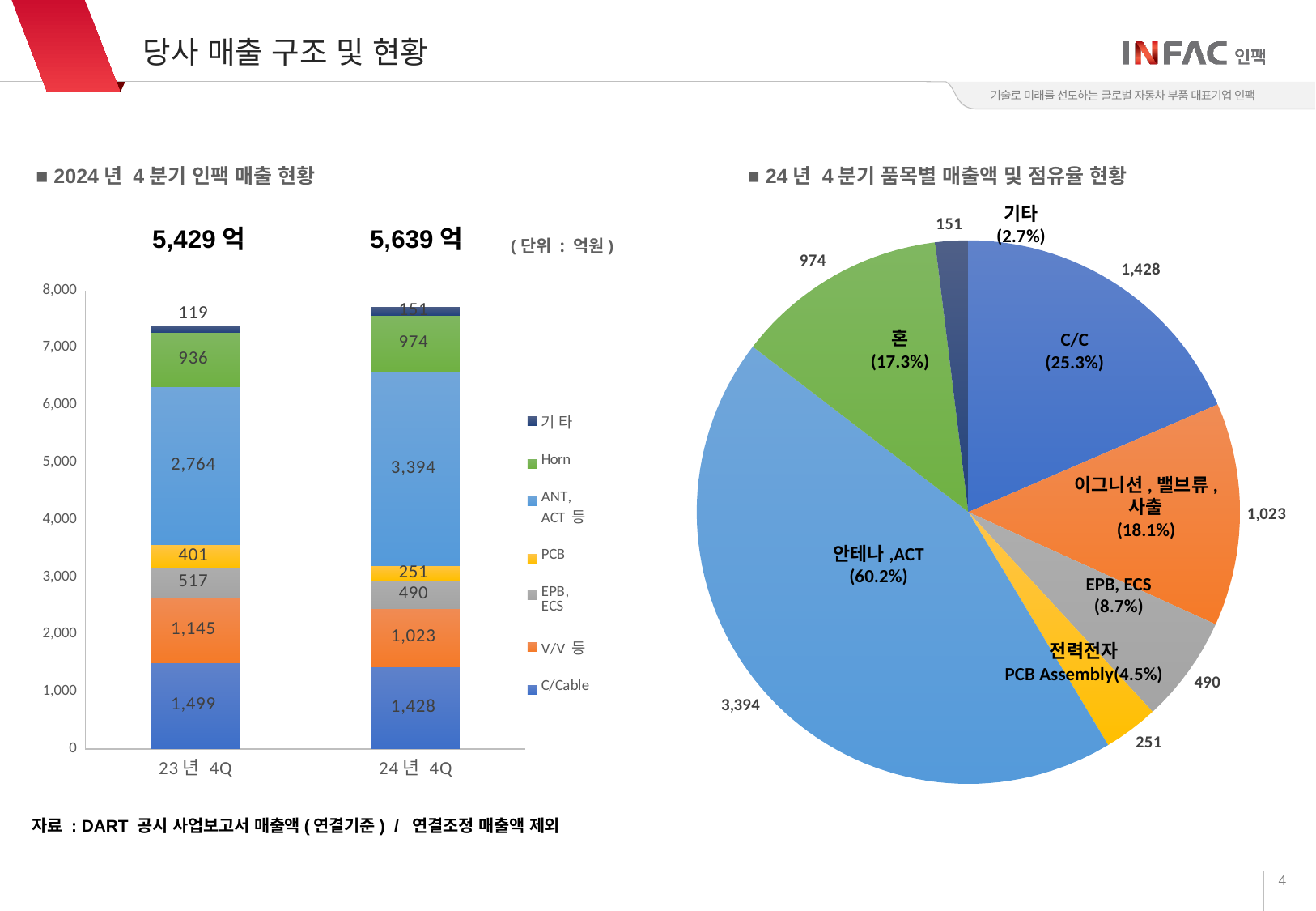
In the left stacked bar chart, by how much did the Horn segment change from 23년 4Q to 24년 4Q? 38 How many series does the legend of the left stacked bar chart list? 7 In the left stacked bar chart, what is the value of the C/Cable segment for 23년 4Q? 1,499 In the right pie chart (24년 4분기 품목별 매출액 및 점유율 현황), what share does 안테나,ACT hold? 60.2% In the right pie chart, what is the difference between the C/C value and the 이그니션, 밸브류, 사출 value? 405 What kind of chart is the left chart on the slide? Stacked bar chart In the left stacked bar chart, is the PCB segment larger in 23년 4Q or 24년 4Q? 23년 4Q How many bars (categories) are shown in the left stacked bar chart? 2 In the left stacked bar chart, does the ANT, ACT 등 segment rise or fall from 23년 4Q to 24년 4Q? Rise In the right pie chart, which item has the smallest slice? 기타 In the right pie chart, what is the value shown for EPB, ECS? 490 In the left stacked bar chart (2024년 4분기 인팩 매출 현황), what is the value of the ANT, ACT 등 segment for 24년 4Q? 3,394